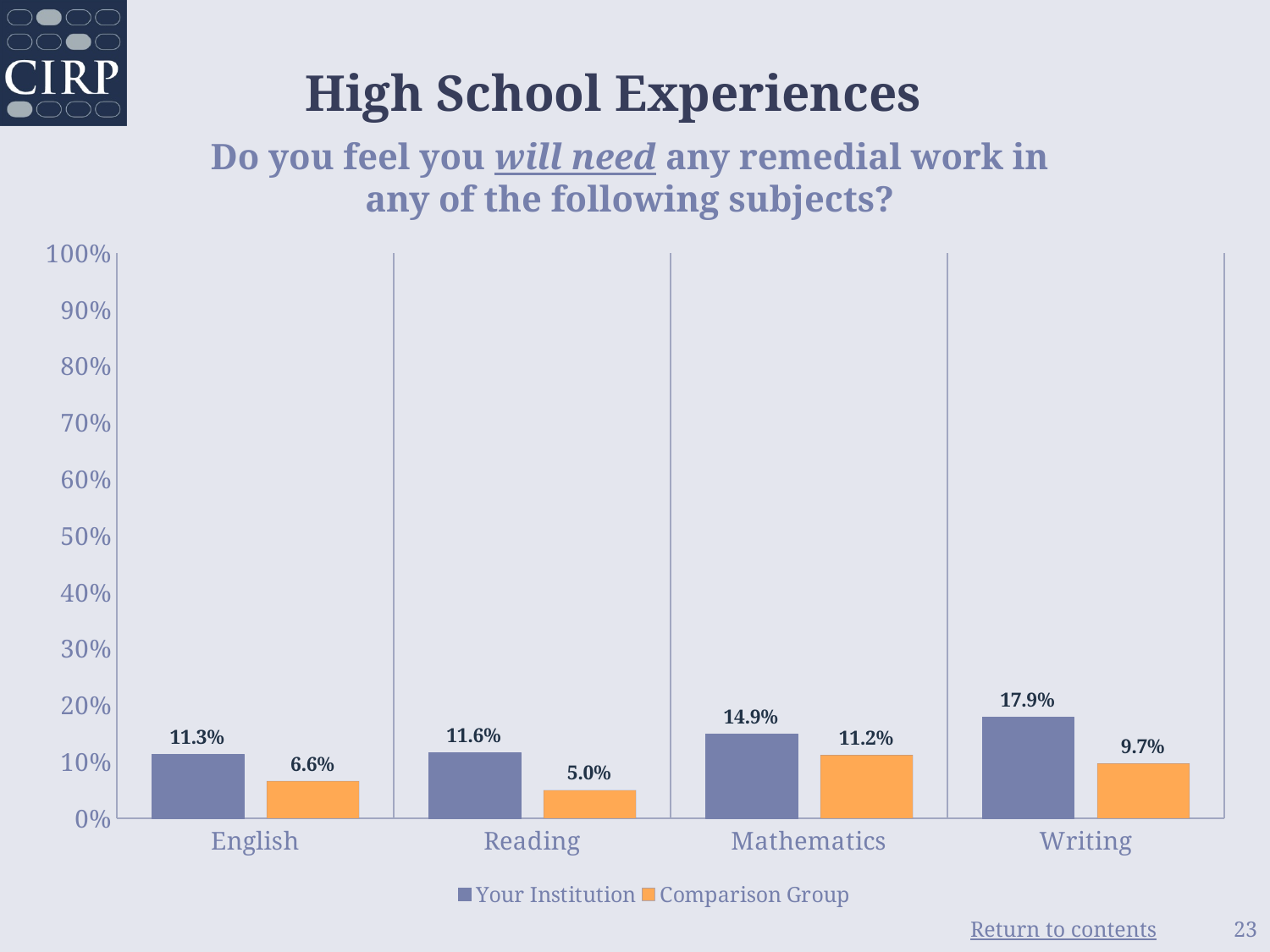
What is the value for Comparison Group in Reading? 5.0% Which is larger in Mathematics: Your Institution or Comparison Group? Your Institution What is the value for Your Institution in Mathematics? 14.9% What colour are the Comparison Group bars? orange Is the value for Your Institution in Writing greater or less than 20%? less Which subject has the lowest value for Comparison Group? Reading What is the value for Your Institution in Writing? 17.9% How many subjects are shown on the x axis? 4 Which subject has the highest value for Your Institution? Writing What kind of chart is shown on the slide? bar chart What is the difference between Your Institution and Comparison Group in English? 4.7% How many series does the legend list? 2